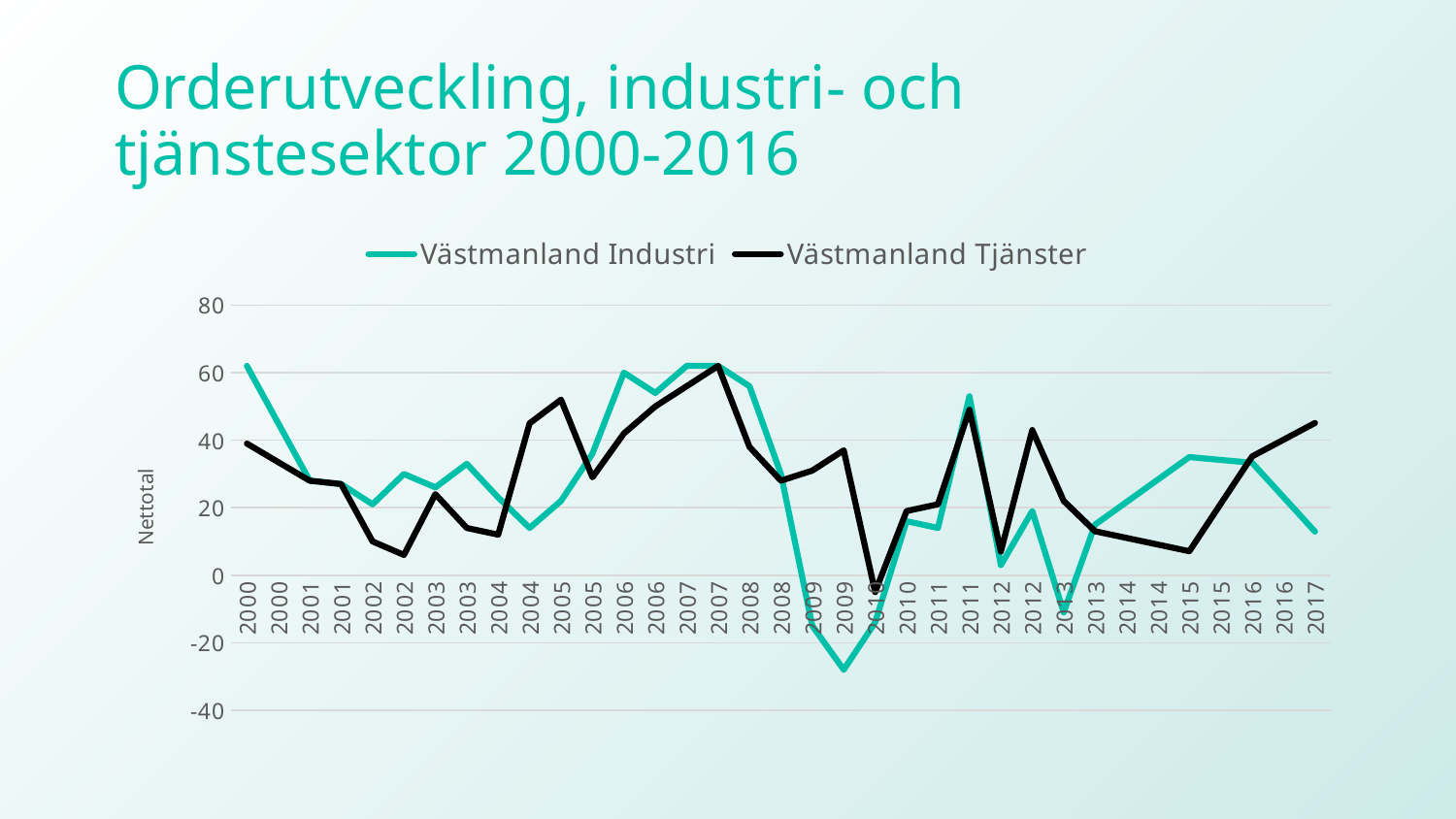
At the first point (2000), which series has the larger value, Västmanland Industri or Västmanland Tjänster? Västmanland Industri Is the value for Västmanland Industri at 2017 greater or less than 20? less Does the Västmanland Industri line rise or fall from 2016 to 2017? fall In which year does Västmanland Industri reach its lowest value? 2009 What is the label on the vertical axis? Nettotal Is the value for Västmanland Industri at the first point (2000) greater or less than 40? greater What kind of chart is shown on the slide? line chart Is the lowest value of Västmanland Industri greater or less than -20? less How many series does the legend list? 2 What is the title of the chart on the slide? Orderutveckling, industri- och tjänstesektor 2000-2016 At 2017, which series has the larger value, Västmanland Industri or Västmanland Tjänster? Västmanland Tjänster